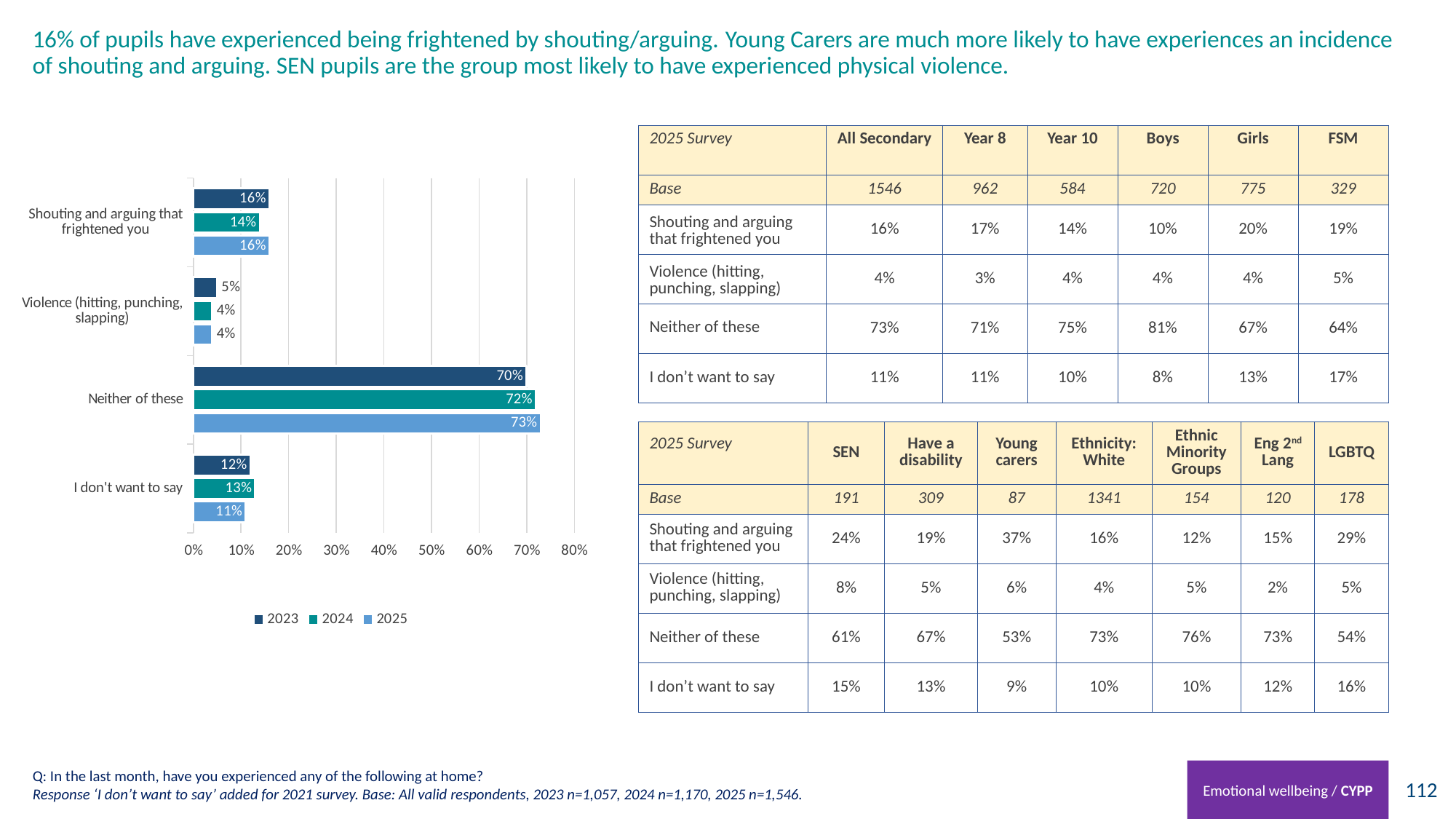
In the bar chart, is the 2023 value for 'I don't want to say' larger or smaller than the 2025 value? larger What is the 2023 value for 'Violence (hitting, punching, slapping)' in the bar chart? 5% Which category has the lowest value for 2024 in the bar chart? Violence (hitting, punching, slapping) What are the series names listed in the legend of the bar chart? 2023, 2024, 2025 What is the difference between the 2025 and 2023 values for 'Neither of these' in the bar chart? 3% What is the 2023 value for 'Shouting and arguing that frightened you' in the bar chart? 16% Which category has the highest value for 2025 in the bar chart? Neither of these What is the 2025 value for 'Neither of these' in the bar chart? 73% How many series does the legend of the bar chart list? 3 What type of chart is shown on the slide? bar chart How many categories are shown on the bar chart? 4 What is the 2024 value for 'I don't want to say' in the bar chart? 13%